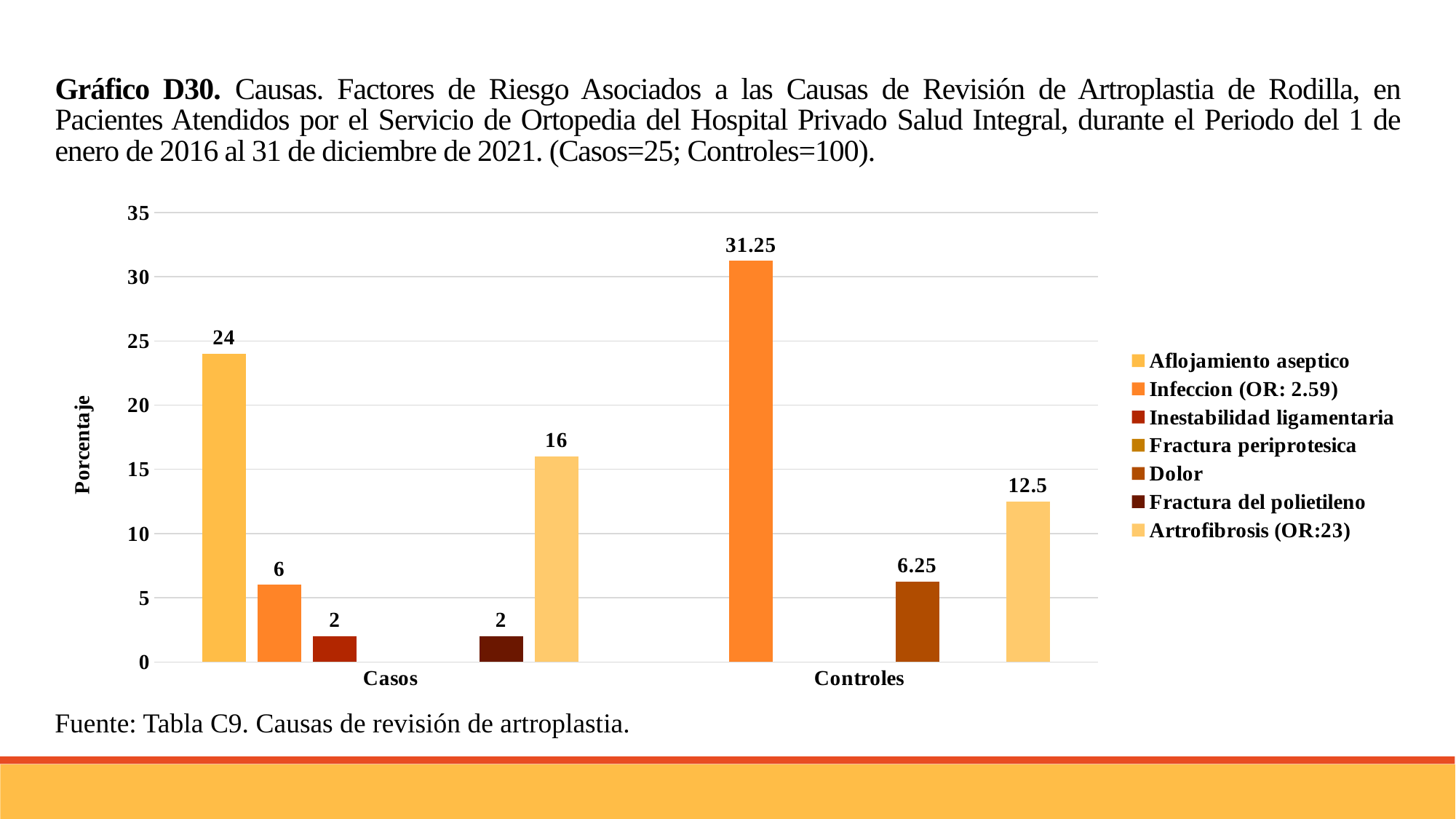
What type of chart is shown on the slide? bar chart What is the value for Artrofibrosis (OR:23) in the Casos category? 16 What is the difference between the Artrofibrosis (OR:23) values for Casos and Controles? 3.5 What is the value for Dolor in the Controles category? 6.25 What is the value for Infeccion (OR: 2.59) in the Controles category? 31.25 How many categories are shown on the x axis? 2 How many series does the legend list? 7 Which is larger: the Infeccion (OR: 2.59) value for Casos or for Controles? Controles Which series has the highest value in the Controles category? Infeccion (OR: 2.59) What is the label of the y axis? Porcentaje What is the value for Aflojamiento aseptico in the Casos category? 24 Which series has the highest value in the Casos category? Aflojamiento aseptico